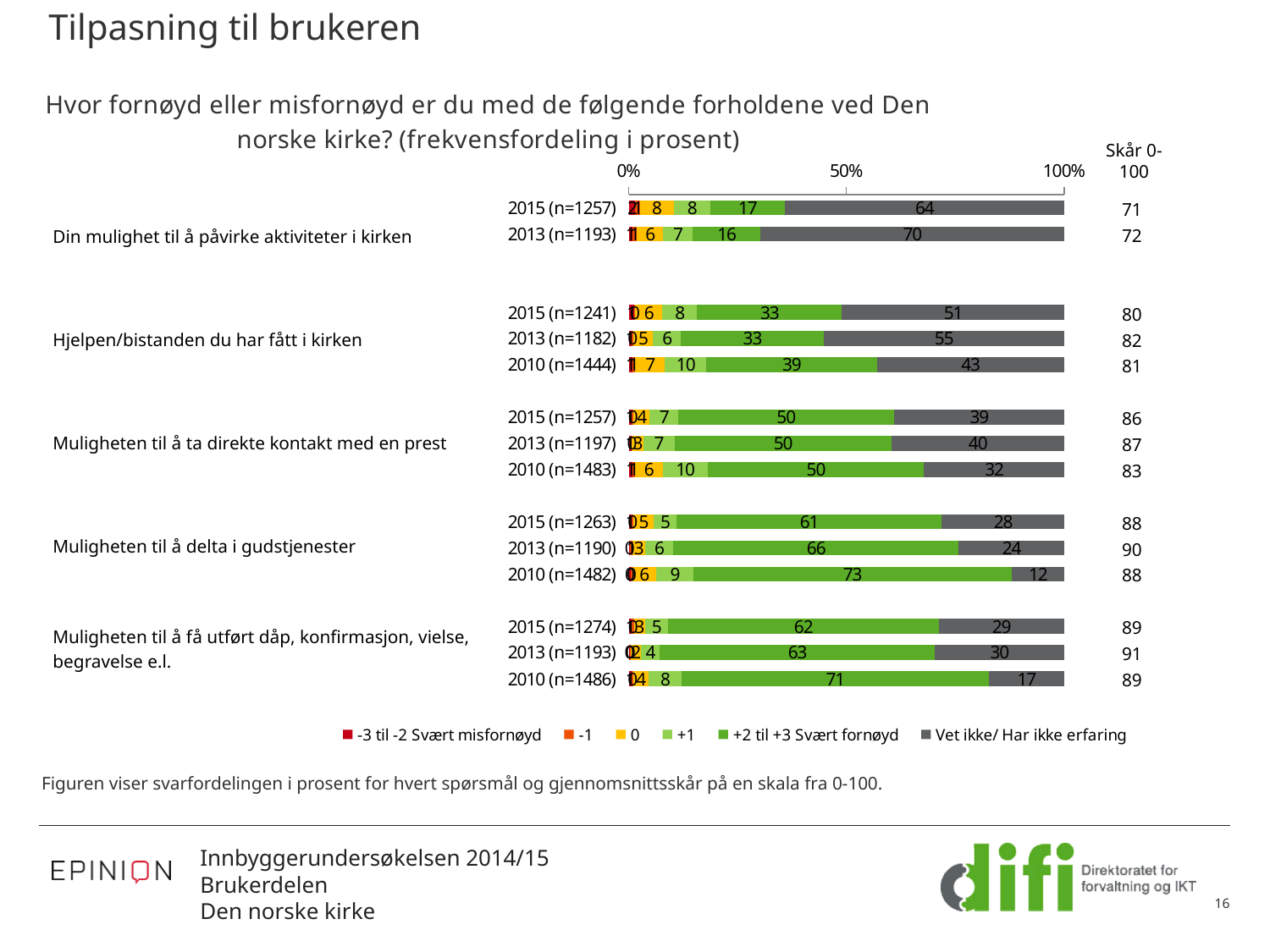
Which row has the lowest Skår 0-100 value? Din mulighet til å påvirke aktiviteter i kirken, 2015 (n=1257) What percentage answered "+2 til +3 Svært fornøyd" for "Muligheten til å delta i gudstjenester" in 2010 (n=1482)? 73 For "Hjelpen/bistanden du har fått i kirken", which year has the larger "Vet ikke/ Har ikke erfaring" share, 2013 or 2010? 2013 How many bars are plotted in the chart in total? 14 For "Din mulighet til å påvirke aktiviteter i kirken", what is the difference in the "Vet ikke/ Har ikke erfaring" share between 2013 and 2015? 6 How many series does the legend list? 6 What kind of chart is shown on the slide? Stacked bar chart What percentage answered "Vet ikke/ Har ikke erfaring" for "Din mulighet til å påvirke aktiviteter i kirken" in 2015 (n=1257)? 64 For "Muligheten til å delta i gudstjenester", which year has the highest share of "+2 til +3 Svært fornøyd"? 2010 (n=1482) What is the Skår 0-100 value for "Muligheten til å få utført dåp, konfirmasjon, vielse, begravelse e.l." in 2013 (n=1193)? 91 What is the Skår 0-100 value for "Muligheten til å ta direkte kontakt med en prest" in 2015 (n=1257)? 86 For "Muligheten til å delta i gudstjenester", does the "Vet ikke/ Har ikke erfaring" share increase or decrease from 2010 to 2015? Increase